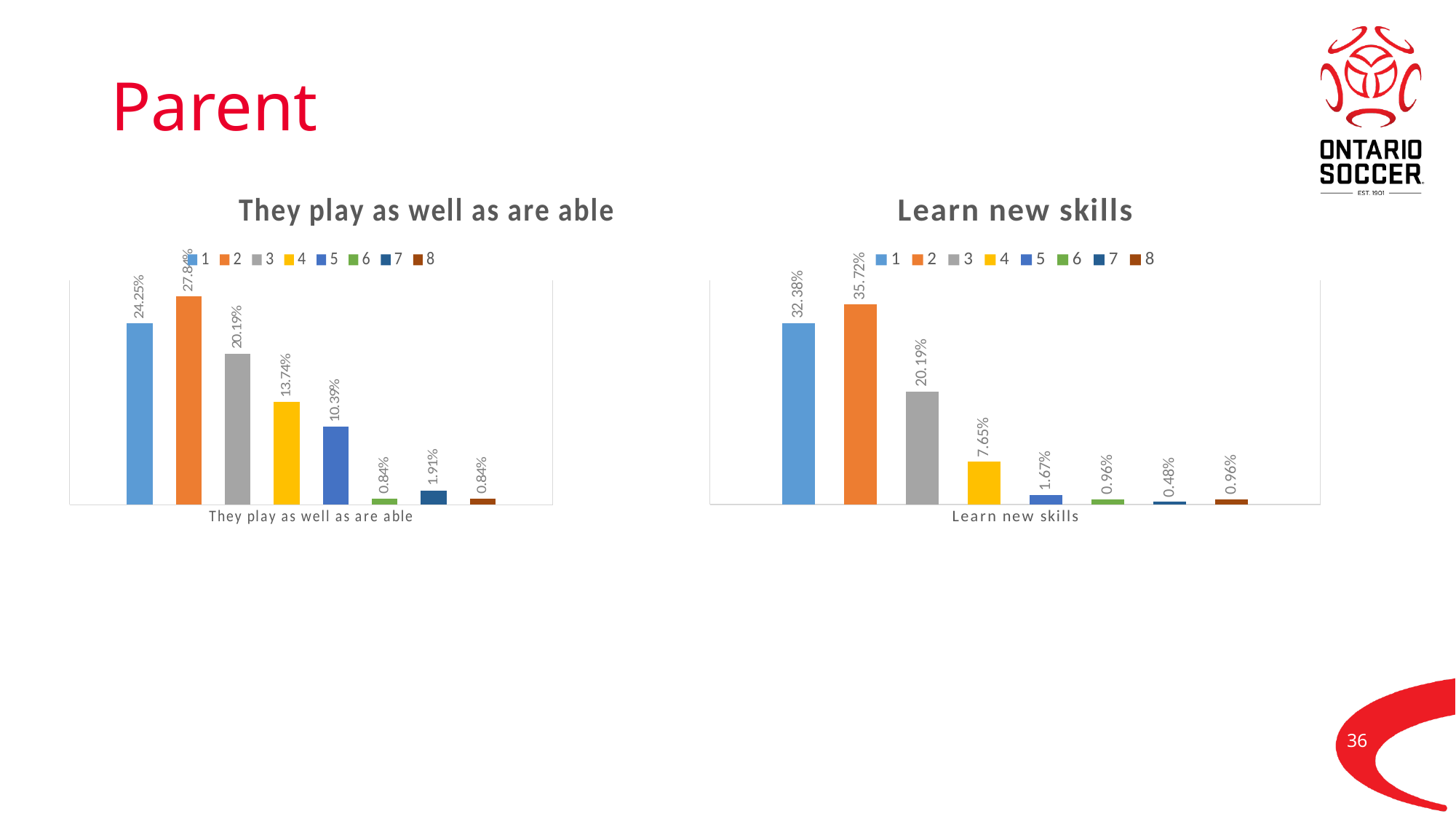
In the 'Learn new skills' chart, which series has the lowest value? 7 In the 'They play as well as are able' chart, what is the value for series 1? 24.25% In the 'Learn new skills' chart, what is the value for series 4? 7.65% In the 'Learn new skills' chart, what is the difference between series 2 and series 1? 3.34% How many series does the legend of the 'Learn new skills' chart list? 8 In the 'They play as well as are able' chart, what is the value for series 4? 13.74% In the 'They play as well as are able' chart, which series has the highest value? 2 In the 'Learn new skills' chart, what is the value for series 2? 35.72% In the 'They play as well as are able' chart, which is larger, series 7 or series 6? 7 In the 'Learn new skills' chart, which is larger, series 5 or series 6? 5 In the 'They play as well as are able' chart, what is the difference between series 3 and series 5? 9.80% What kind of chart is the 'They play as well as are able' chart? Bar chart